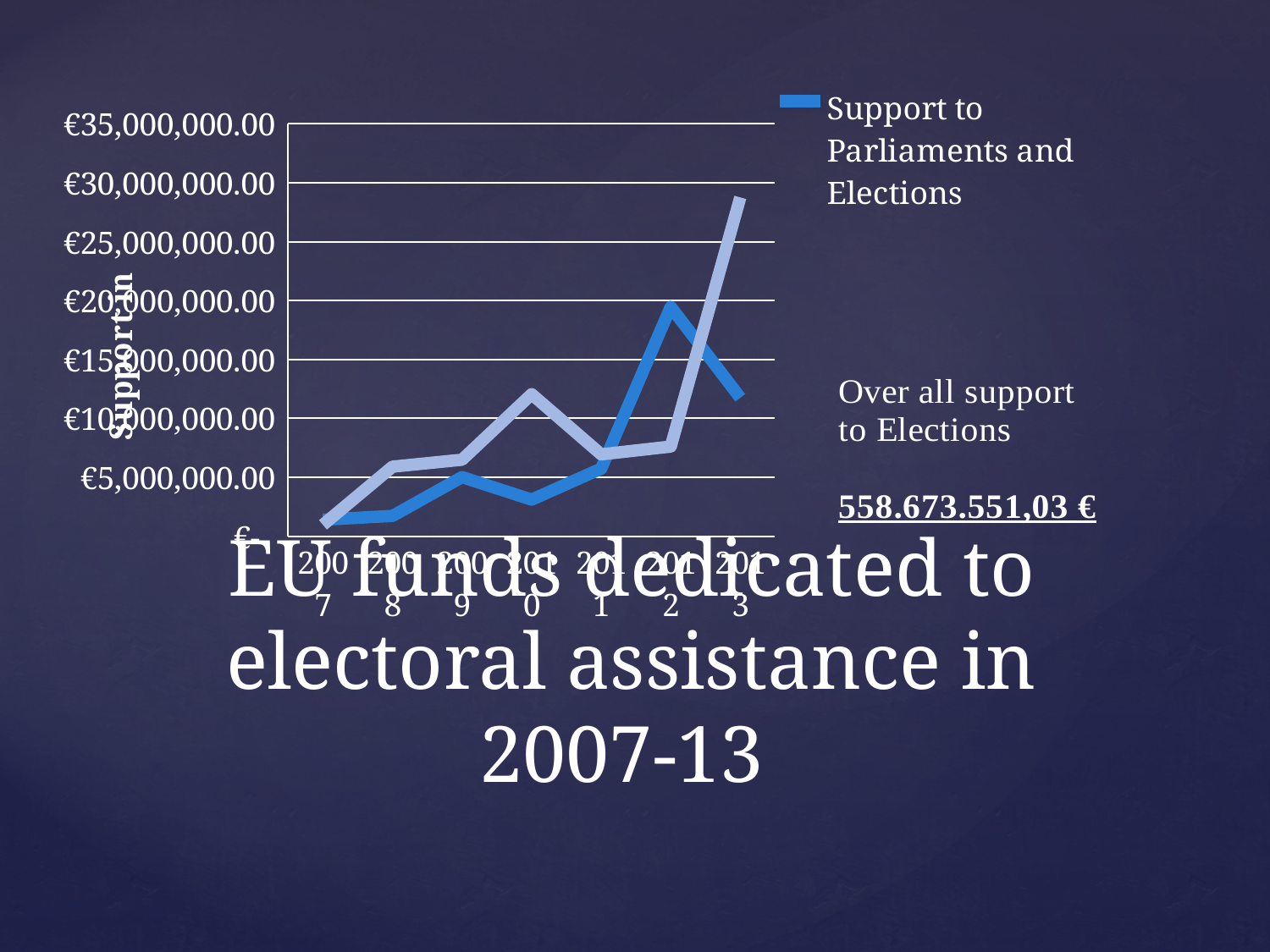
Is the value for 'Over all support to Elections' in 2013 greater or less than €25,000,000.00? greater What total figure is printed under the legend entry 'Over all support to Elections'? 558.673.551,03 € How many series does the chart's legend list? 2 How many years are plotted along the x axis of the chart? 7 Is the value for 'Over all support to Elections' in 2010 greater or less than €10,000,000.00? greater Is the value for 'Support to Parliaments and Elections' in 2012 greater or less than €15,000,000.00? greater In 2013, which series has the higher value: 'Support to Parliaments and Elections' or 'Over all support to Elections'? Over all support to Elections What kind of chart is shown on the slide? line chart In which year is the 'Over all support to Elections' line at its lowest value? 2007 In which year does the 'Support to Parliaments and Elections' line reach its highest value? 2012 In which year does the 'Over all support to Elections' line reach its highest value? 2013 In 2012, which series has the higher value: 'Support to Parliaments and Elections' or 'Over all support to Elections'? Support to Parliaments and Elections